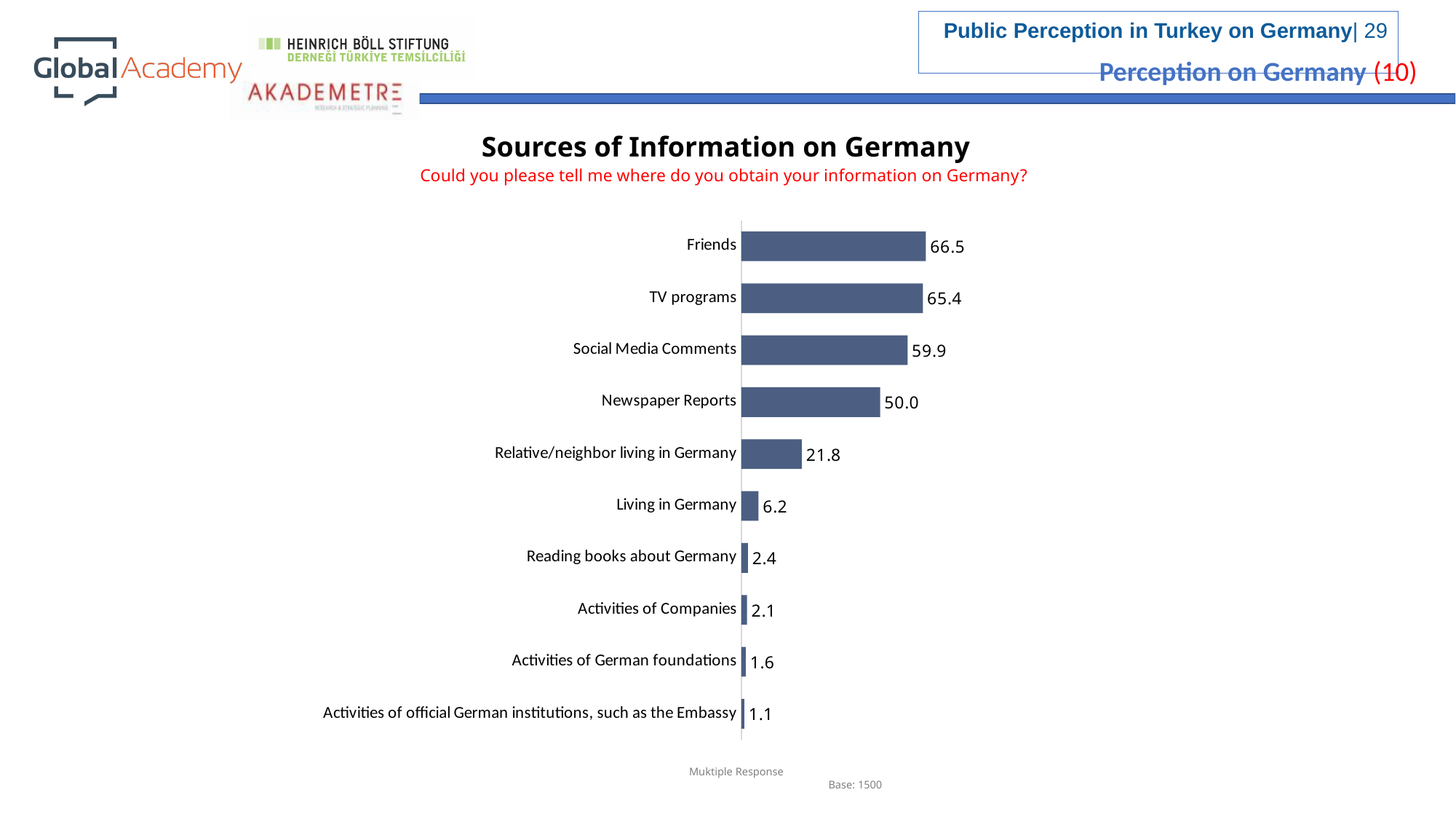
Which category has the highest value? Friends Which category has the lowest value? Activities of official German institutions, such as the Embassy Which is larger, the value for TV programs or the value for Social Media Comments? TV programs What is the value for Social Media Comments? 59.9 What is the title of the chart? Sources of Information on Germany What is the difference between the values for Newspaper Reports and Relative/neighbor living in Germany? 28.2 What is the value for Relative/neighbor living in Germany? 21.8 What is the value for Friends? 66.5 What is the base (number of respondents) noted below the chart? 1500 What is the value for Activities of German foundations? 1.6 How many categories are shown in the chart? 10 What kind of chart is shown on the slide? Bar chart